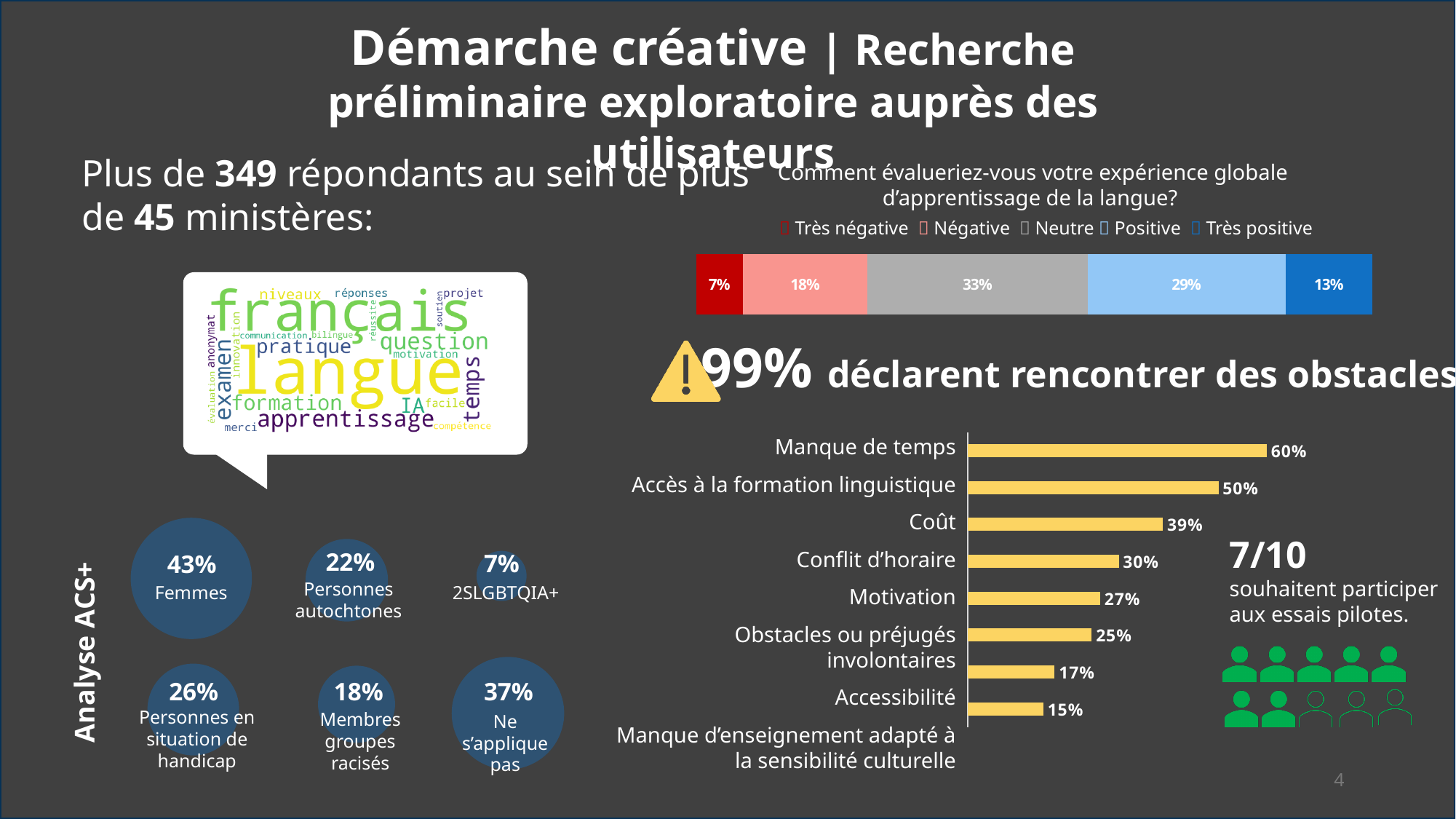
In the obstacles bar chart, what percentage is shown for 'Manque de temps'? 60% In the stacked bar for 'Comment évalueriez-vous votre expérience globale d'apprentissage de la langue?', what percentage is 'Neutre'? 33% In the obstacles bar chart, which obstacle has the lowest value? Manque d'enseignement adapté à la sensibilité culturelle How many categories does the legend of the overall learning experience stacked bar list? 5 How many obstacle categories are listed in the obstacles bar chart? 8 What kind of chart is used to show the obstacles? Bar chart In the stacked bar for the overall learning experience, what percentage is 'Très négative'? 7% In the obstacles bar chart, what percentage is shown for 'Coût'? 39% In the obstacles bar chart, what is the difference between 'Manque de temps' and 'Accès à la formation linguistique'? 10% In the obstacles bar chart, which is larger: 'Conflit d'horaire' or 'Motivation'? Conflit d'horaire In the obstacles bar chart, which obstacle has the highest value? Manque de temps In the overall learning experience stacked bar, what is the combined share of 'Positive' and 'Très positive'? 42%